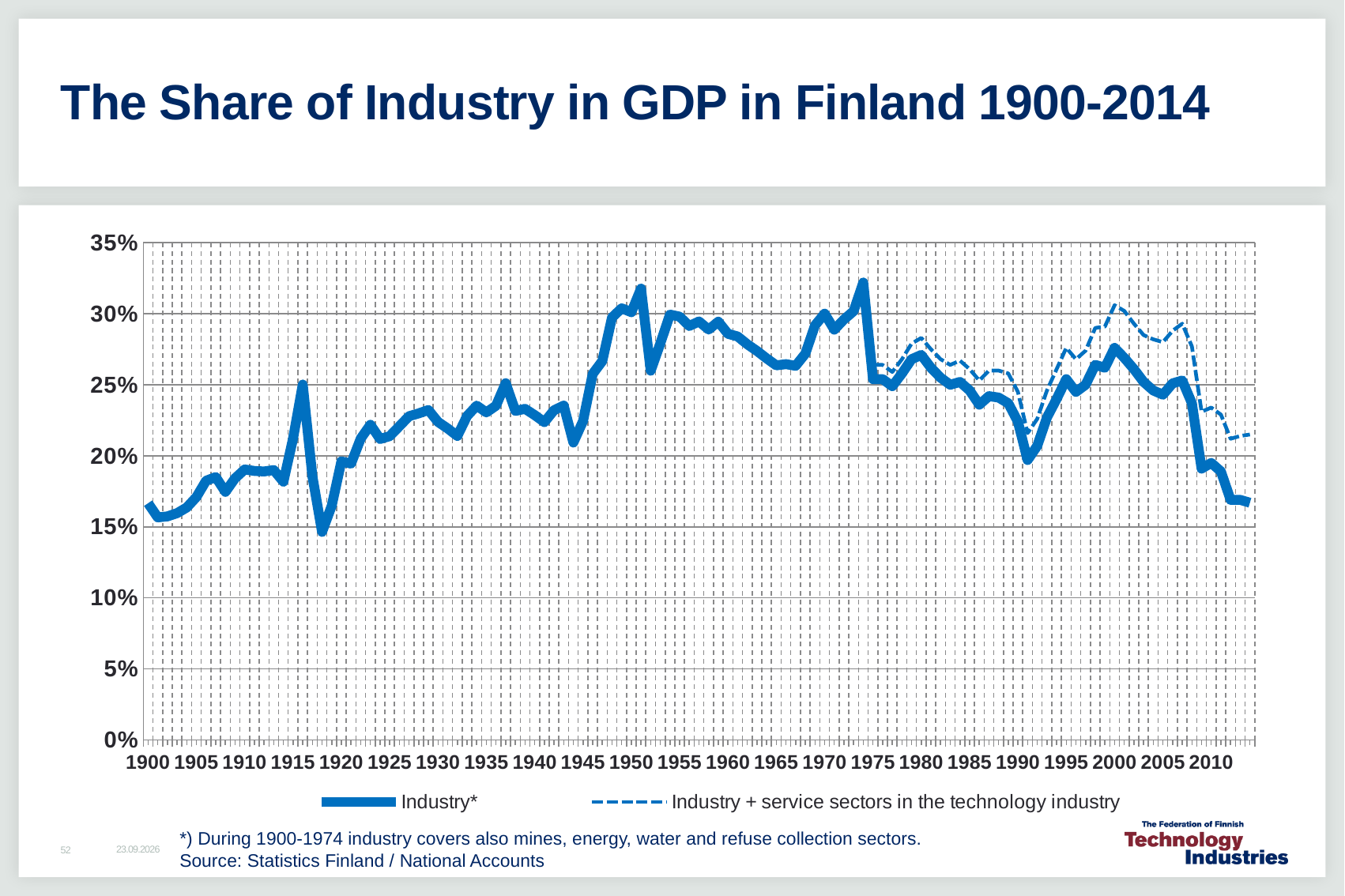
Is the value for Industry* in 1974 greater or less than 30%? greater In 2000, which series has the higher value: Industry* or Industry + service sectors in the technology industry? Industry + service sectors in the technology industry Is the value for Industry* in 2014 greater or less than 20%? less Does the Industry* series rise or fall between 2007 and 2014? Fall Which is larger for Industry*: the value in 1974 or the value in 2014? 1974 Is the value for Industry + service sectors in the technology industry in 2014 greater or less than 20%? greater How many series does the legend list? 2 Which series is drawn with a dashed line? Industry + service sectors in the technology industry What kind of chart is shown on the slide? Line chart What is the title of the chart? The Share of Industry in GDP in Finland 1900-2014